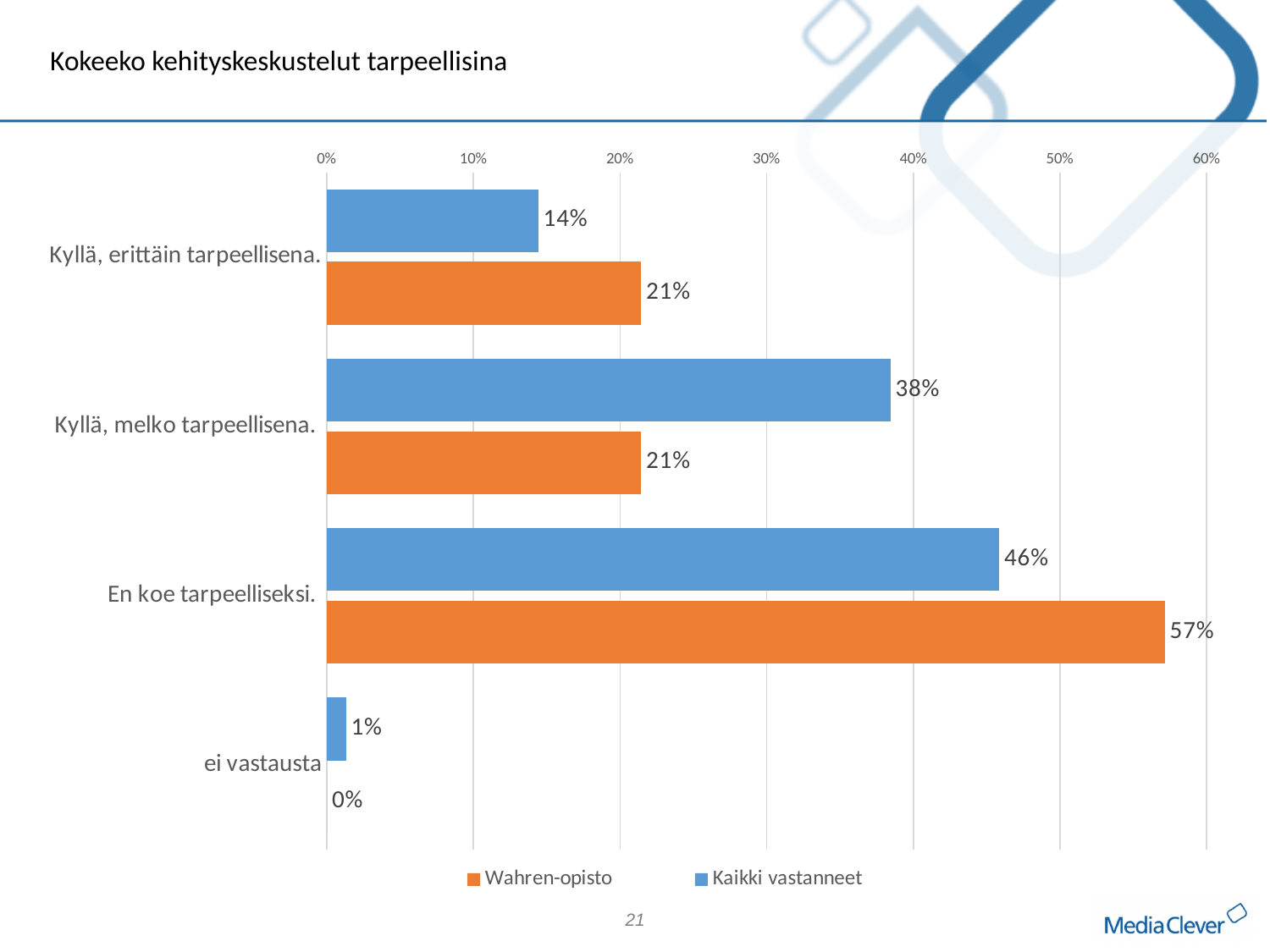
What is the value for Kaikki vastanneet in the category "Kyllä, erittäin tarpeellisena."? 14% What is the value for Wahren-opisto in the category "ei vastausta"? 0% How many categories are shown on the chart? 4 What is the value for Wahren-opisto in the category "En koe tarpeelliseksi."? 57% Is the Kaikki vastanneet value for "En koe tarpeelliseksi." greater or less than 40%? greater Which category has the lowest value for Wahren-opisto? ei vastausta Which category has the highest value for Kaikki vastanneet? En koe tarpeelliseksi. What is the difference between the Wahren-opisto and Kaikki vastanneet values for "En koe tarpeelliseksi."? 11% What kind of chart is shown on the slide? Bar chart For "Kyllä, melko tarpeellisena.", which series has the larger value, Wahren-opisto or Kaikki vastanneet? Kaikki vastanneet What is the value for Kaikki vastanneet in the category "Kyllä, melko tarpeellisena."? 38% How many series does the legend list? 2